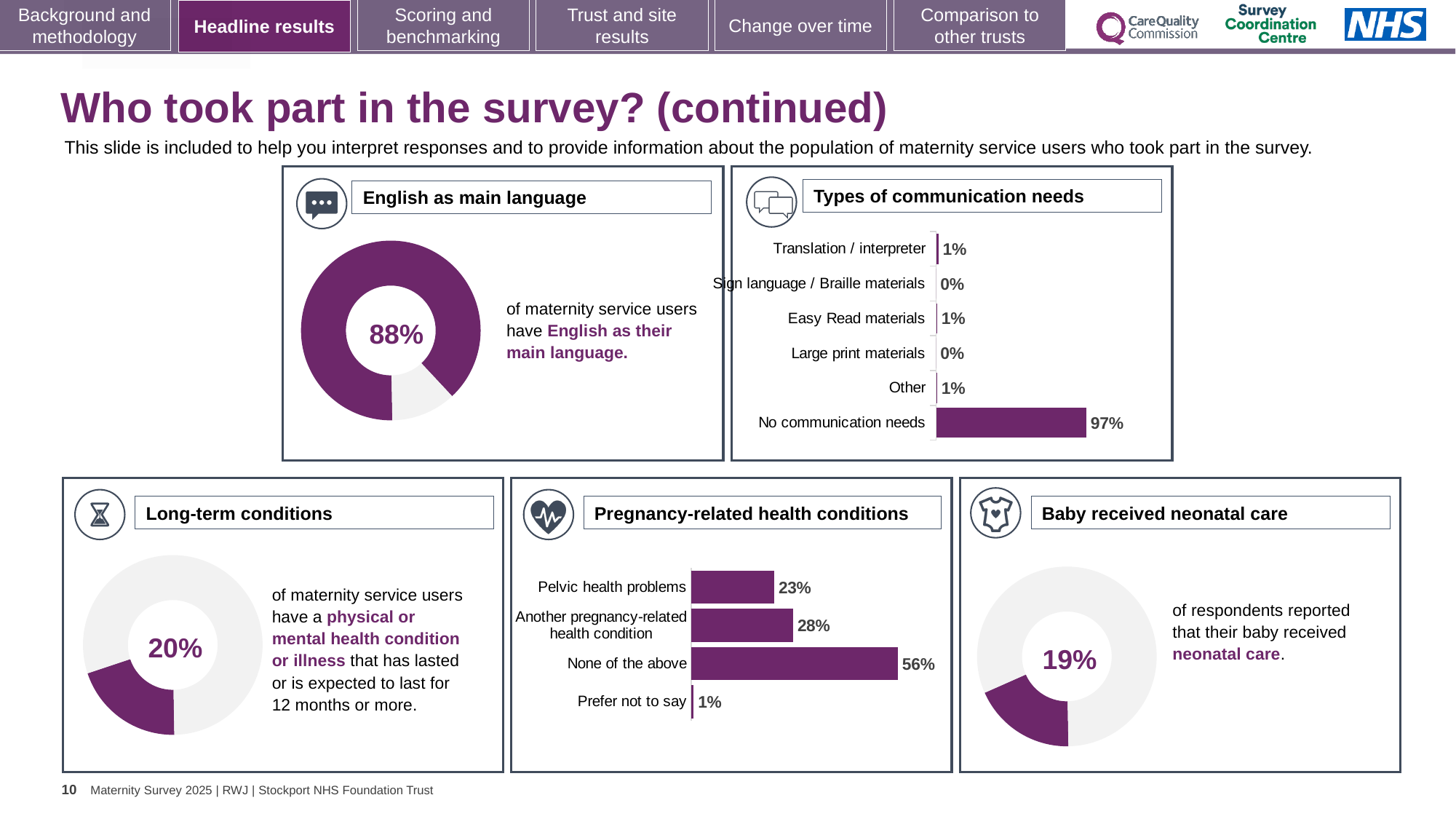
What kind of chart is the 'Types of communication needs' chart? Bar chart How many categories are shown in the 'Types of communication needs' chart? 6 In the 'Types of communication needs' chart, what is the value for 'No communication needs'? 97% In the 'Long-term conditions' donut chart, what percentage of maternity service users have a physical or mental health condition or illness? 20% In the 'Baby received neonatal care' donut chart, what percentage of respondents reported that their baby received neonatal care? 19% In the 'Pregnancy-related health conditions' chart, which category has the highest value? None of the above In the 'Pregnancy-related health conditions' chart, what is the difference between 'None of the above' and 'Another pregnancy-related health condition'? 28% In the 'Pregnancy-related health conditions' chart, what is the value for 'Pelvic health problems'? 23% In the 'Pregnancy-related health conditions' chart, which category has the lowest value? Prefer not to say In the 'English as main language' donut chart, what percentage of maternity service users have English as their main language? 88% In the 'Pregnancy-related health conditions' chart, which is larger: 'Pelvic health problems' or 'Another pregnancy-related health condition'? Another pregnancy-related health condition In the 'Types of communication needs' chart, which category has the highest value? No communication needs